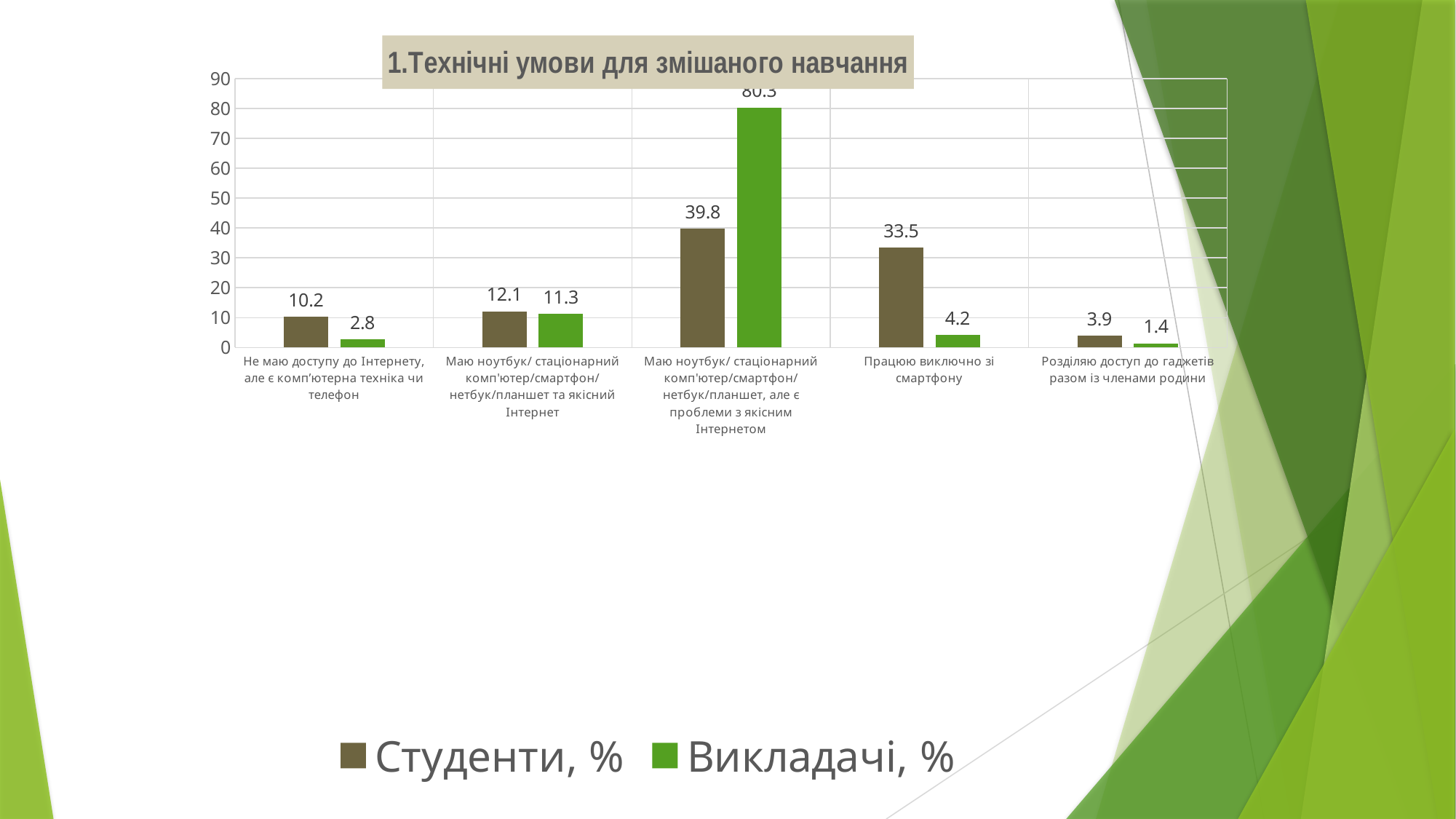
What type of chart is shown on the slide? bar chart What is the value for Студенти, % in the category 'Працюю виключно зі смартфону'? 33.5 How many series does the legend list? 2 Is the value for Викладачі, % in the category 'Маю ноутбук/ стаціонарний комп'ютер/смартфон/ нетбук/планшет, але є проблеми з якісним Інтернетом' greater or less than 70? greater How many categories are shown on the x axis? 5 Which category has the lowest value for Студенти, %? Розділяю доступ до гаджетів разом із членами родини Which category has the highest value for Викладачі, %? Маю ноутбук/ стаціонарний комп'ютер/смартфон/ нетбук/планшет, але є проблеми з якісним Інтернетом In the category 'Маю ноутбук/ стаціонарний комп'ютер/смартфон/ нетбук/планшет та якісний Інтернет', which series has the larger value, Студенти, % or Викладачі, %? Студенти, % What is the title of the chart? 1.Технічні умови для змішаного навчання What is the difference between Студенти, % and Викладачі, % in the category 'Працюю виключно зі смартфону'? 29.3 What is the value for Студенти, % in the category 'Розділяю доступ до гаджетів разом із членами родини'? 3.9 What is the value for Викладачі, % in the category 'Не маю доступу до Інтернету, але є комп'ютерна техніка чи телефон'? 2.8